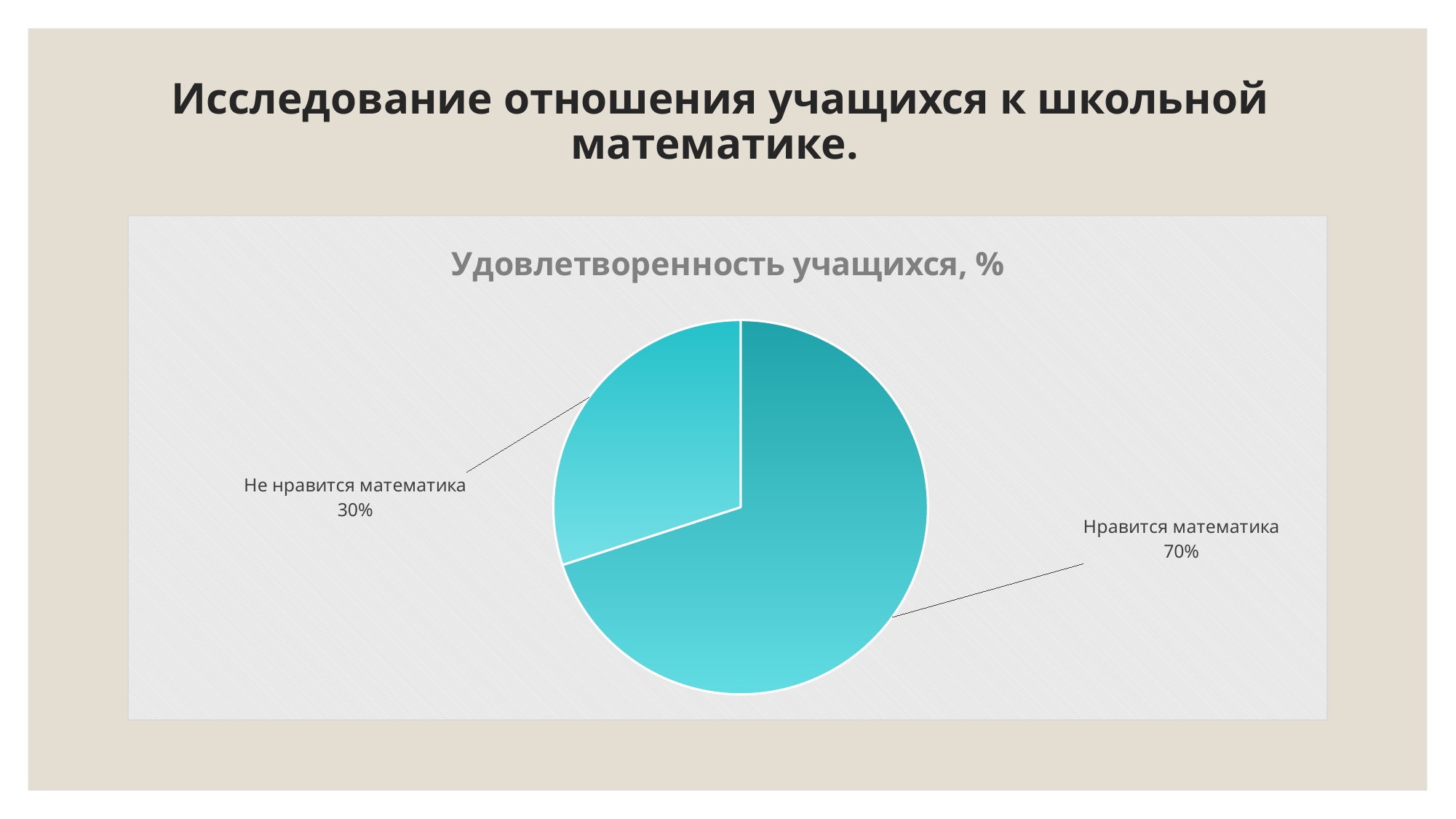
Is the share for "Не нравится математика" greater or less than 50%? less Which slice of the pie is the smallest? Не нравится математика What is the difference in percentage points between "Нравится математика" and "Не нравится математика"? 40 percentage points What share of the pie is labelled "Не нравится математика"? 30% What kind of chart is shown on the slide? pie chart Is the share for "Нравится математика" greater or less than 50%? greater Which is larger: the share for "Нравится математика" or for "Не нравится математика"? Нравится математика How many slices does the pie chart have? 2 What is the total of the two slices shown in the pie chart? 100% What share of the pie is labelled "Нравится математика"? 70% What is the chart's title? Удовлетворенность учащихся, % Which slice of the pie is the largest? Нравится математика